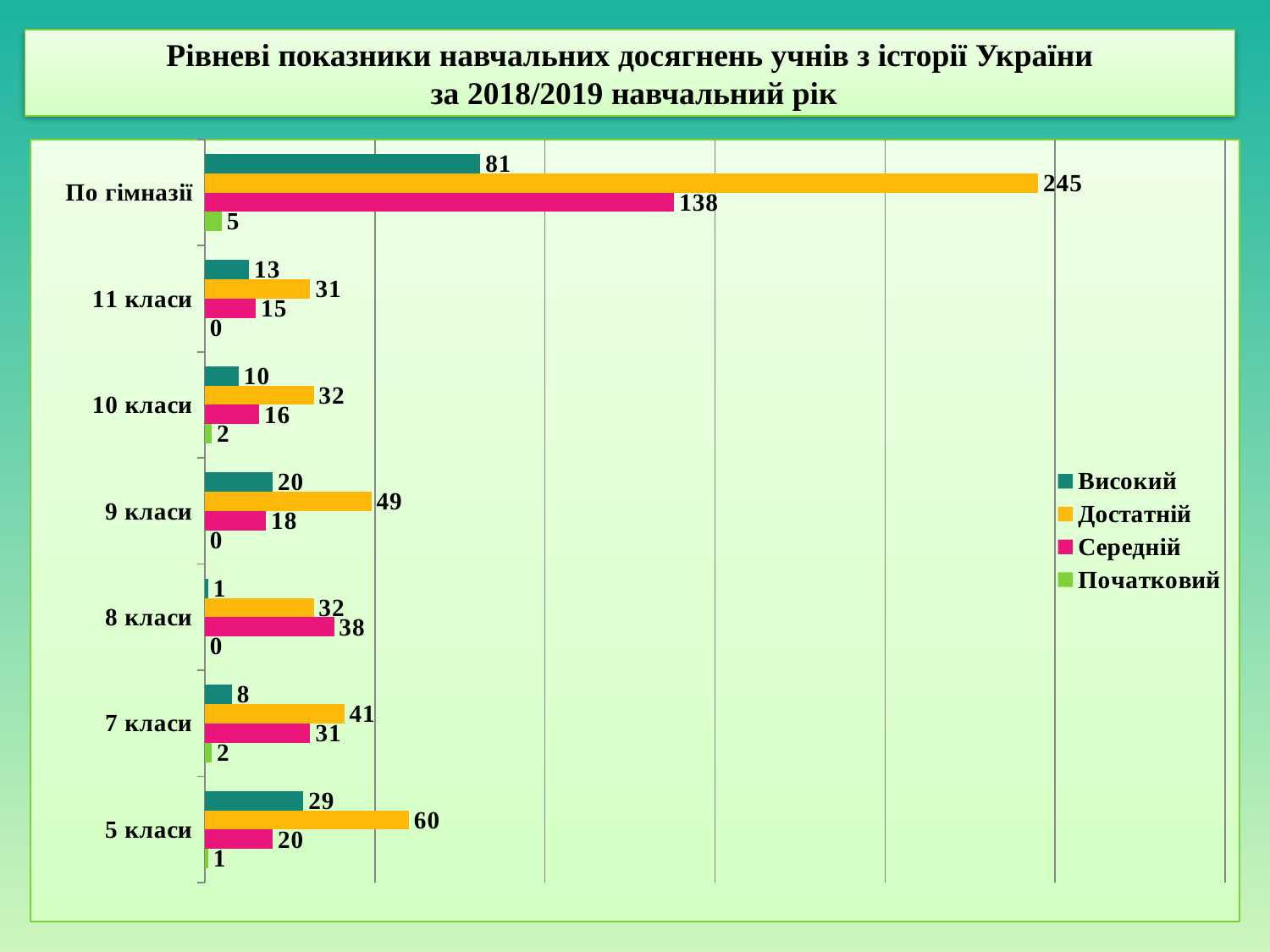
What is the value of Достатній for По гімназії? 245 What kind of chart is shown on the slide? Bar chart Which class category has the highest Достатній value (excluding По гімназії)? 5 класи How many categories are shown on the vertical axis? 7 Which class category has the lowest Високий value? 8 класи What is the difference between the Достатній and Середній values for По гімназії? 107 Which series is shown in orange in the legend? Достатній What is the value of Початковий for 10 класи? 2 How many series does the legend list? 4 Which is larger for 8 класи: Достатній or Середній? Середній What is the value of Середній for 8 класи? 38 What is the value of Високий for 5 класи? 29